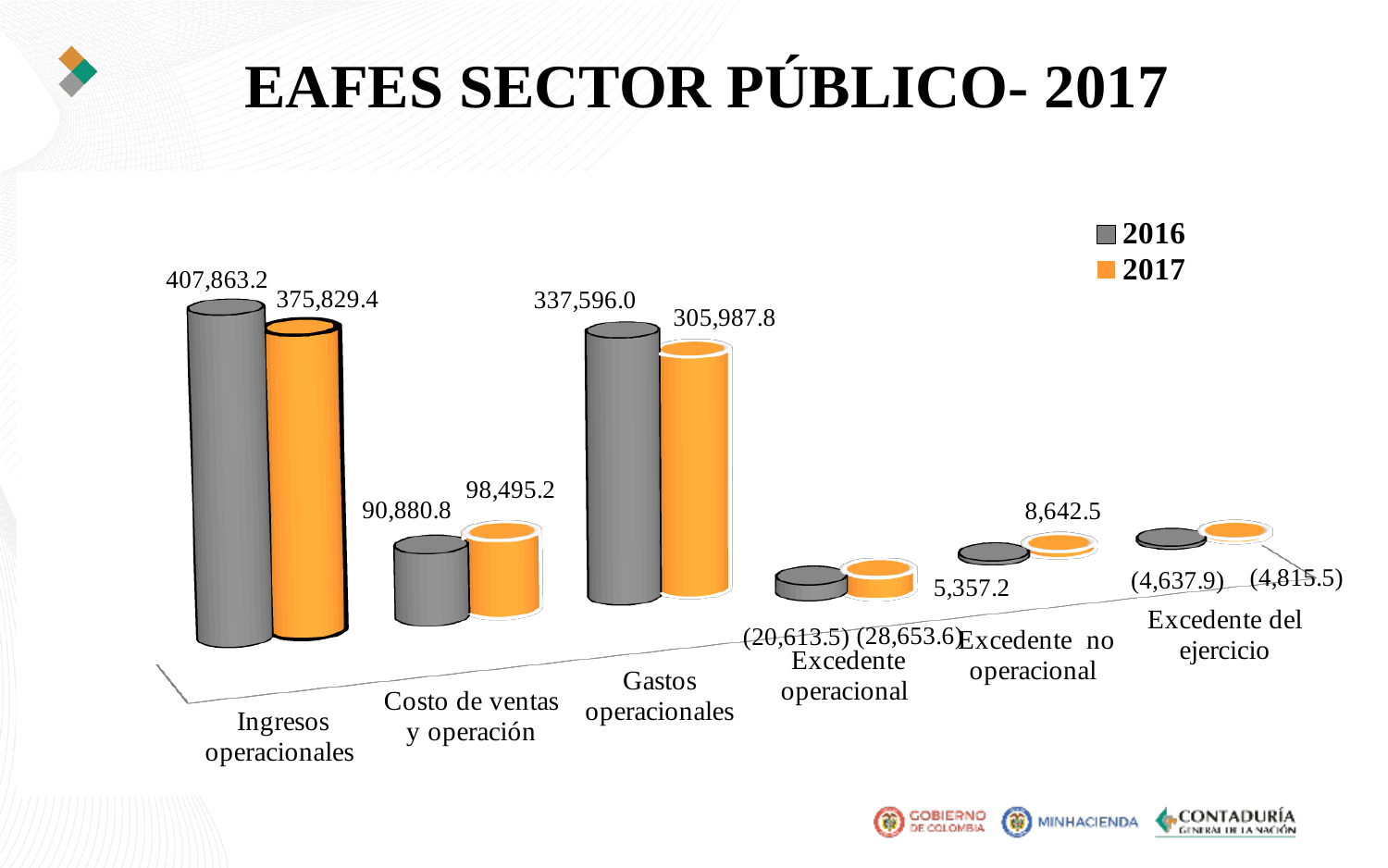
Which category has the highest 2017 value? Ingresos operacionales What is the 2017 value for Costo de ventas y operación? 98,495.2 What is the difference between the 2017 and 2016 values for Excedente no operacional? 3,285.3 How many categories are shown on the x axis? 6 How many series does the legend list? 2 What is the 2016 value for Excedente no operacional? 5,357.2 What is the 2016 value for Ingresos operacionales? 407,863.2 Which is larger for Costo de ventas y operación, the 2016 value or the 2017 value? 2017 What is the 2017 value for Gastos operacionales? 305,987.8 Which category has the lowest 2017 value? Excedente operacional What is the 2017 value for Excedente del ejercicio? (4,815.5) What is the difference between the 2016 and 2017 values for Ingresos operacionales? 32,033.8